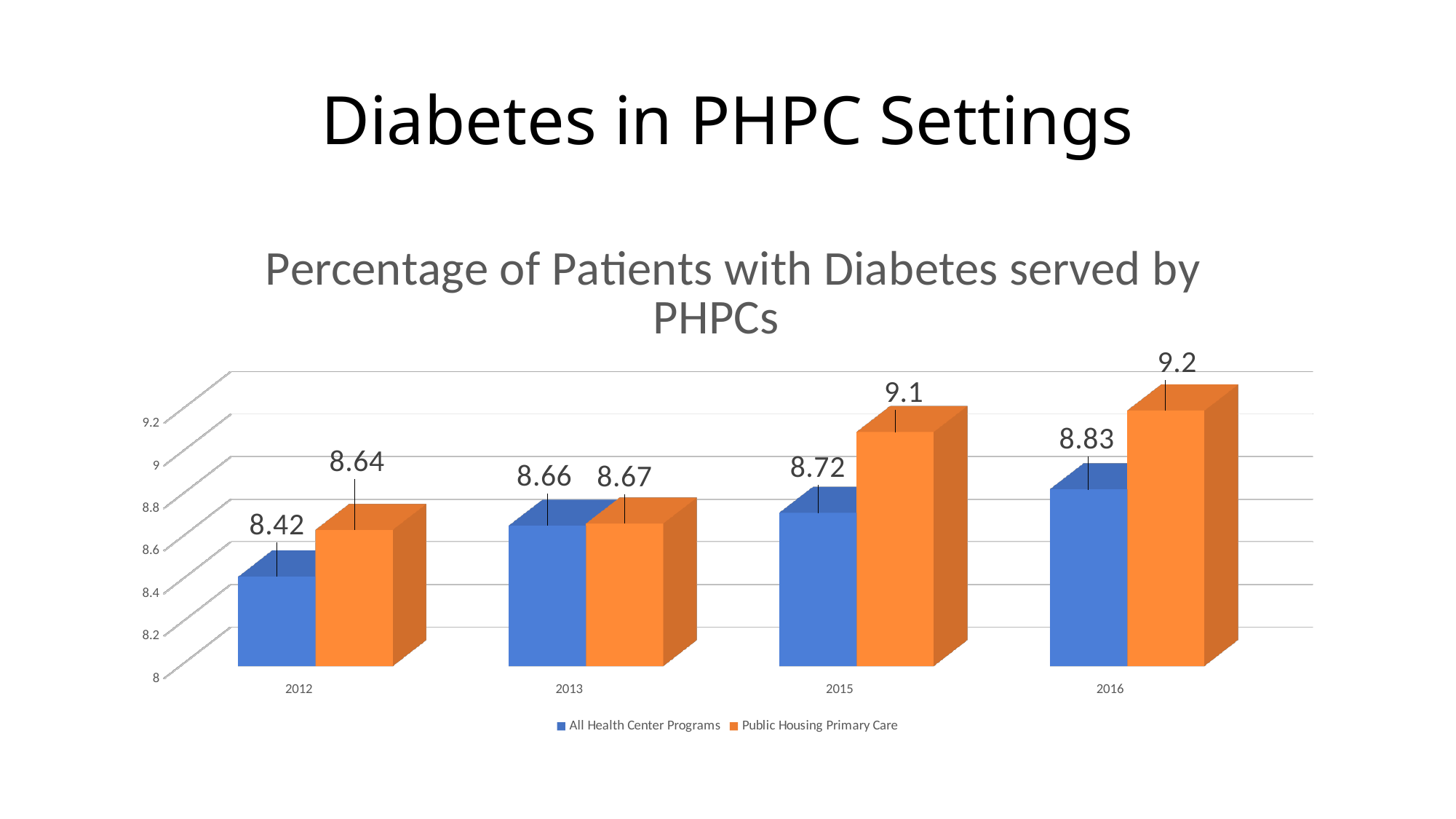
Do the values for Public Housing Primary Care rise or fall from 2012 to 2016? rise Which year has the lowest value for All Health Center Programs? 2012 What kind of chart is this? bar chart What is the value for Public Housing Primary Care in 2015? 9.1 What is the value for All Health Center Programs in 2012? 8.42 Which year has the highest value for Public Housing Primary Care? 2016 How many years are shown on the x axis? 4 What is the title of the chart? Percentage of Patients with Diabetes served by PHPCs What is the value for Public Housing Primary Care in 2016? 9.2 How many series does the legend list? 2 What is the difference between Public Housing Primary Care and All Health Center Programs in 2015? 0.38 Which is larger in 2016, All Health Center Programs or Public Housing Primary Care? Public Housing Primary Care